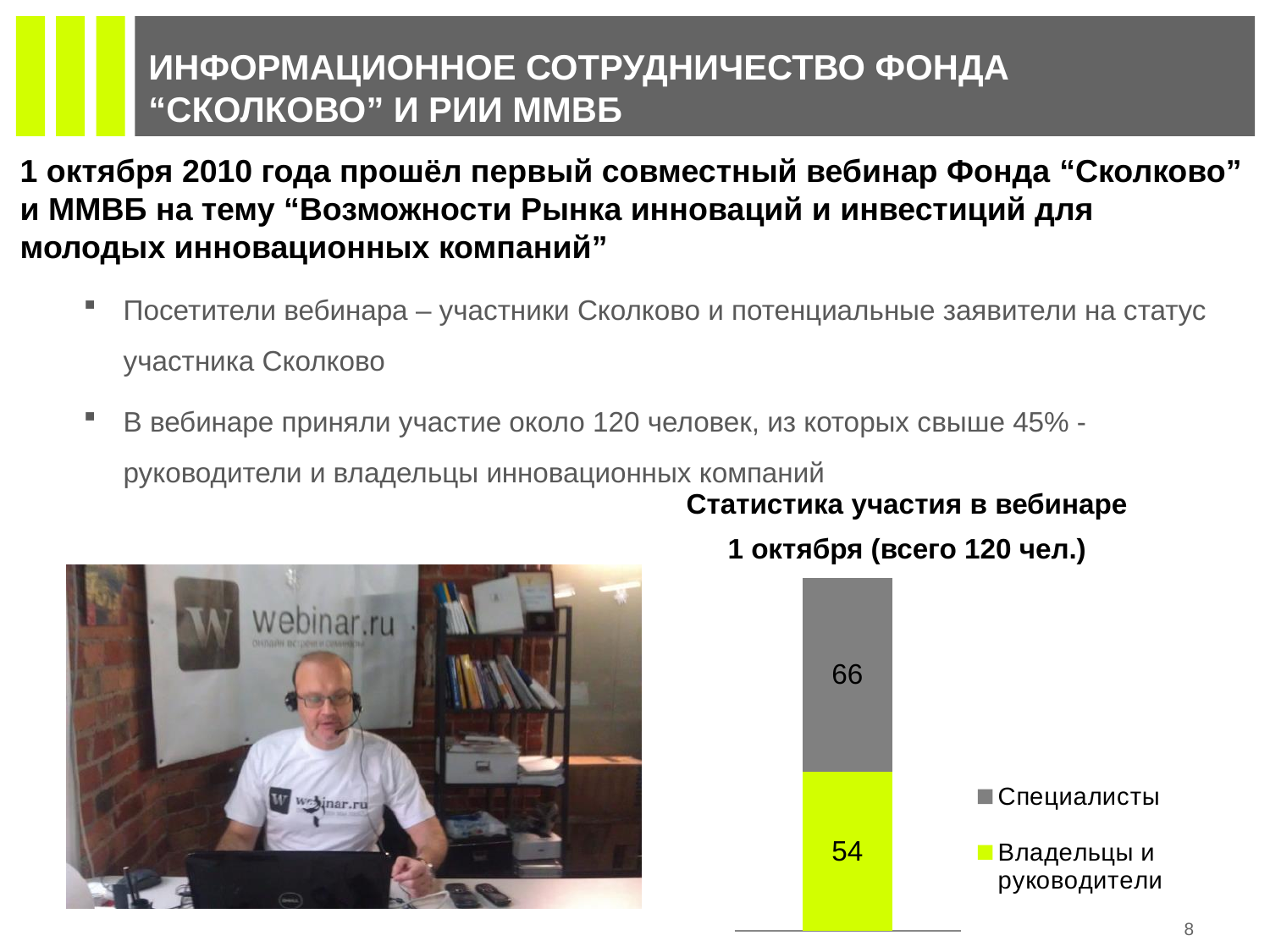
How many series does the legend list? 2 Which series has the larger value, Специалисты or Владельцы и руководители? Специалисты What is the total of the stacked bar? 120 What is the value for Владельцы и руководители in the chart? 54 Which series has the smallest value in the chart? Владельцы и руководители What is the value for Специалисты in the chart? 66 What kind of chart is shown on the slide? Stacked bar chart What is the difference between the Специалисты value and the Владельцы и руководители value? 12 What is the title of the chart? Статистика участия в вебинаре 1 октября (всего 120 чел.) Which series is shown in bright green in the chart? Владельцы и руководители Which series has the largest value in the chart? Специалисты How many bars are plotted in the chart? 1